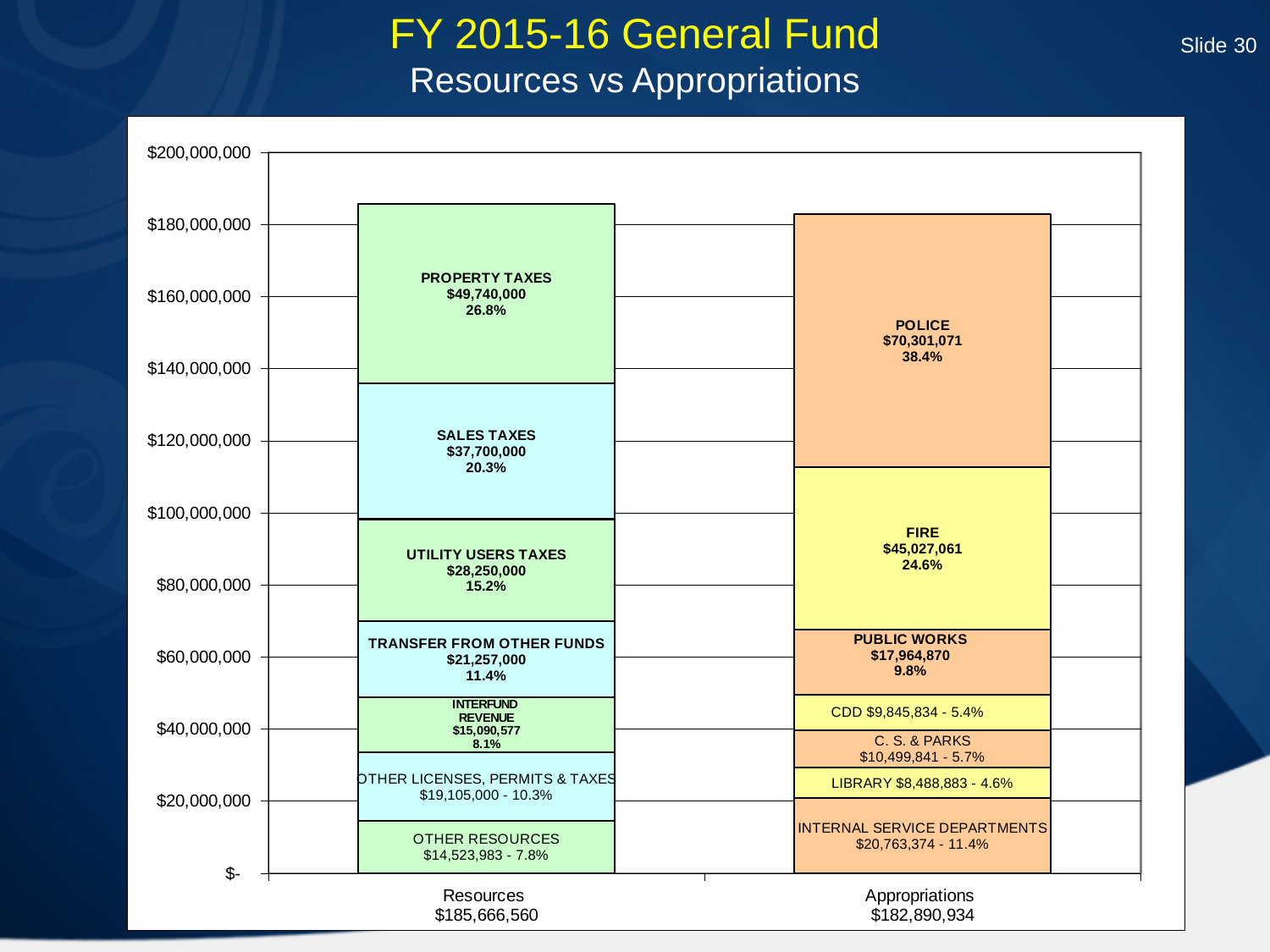
What is the value of the Fire segment in the Appropriations bar? $45,027,061 Which is larger, the Sales Taxes segment or the Utility Users Taxes segment? Sales Taxes What is the value of the Property Taxes segment in the Resources bar? $49,740,000 How many bars (categories) are plotted on the x axis? 2 What percentage of Appropriations does Police account for? 38.4% Which segment is the smallest in the Appropriations bar? Library What is the difference between the Police and Fire appropriations? $25,274,010 Which segment is the largest in the Appropriations bar? Police What is the total of the Appropriations bar? $182,890,934 What is the value of the Internal Service Departments segment? $20,763,374 What kind of chart is shown on the slide? Stacked bar chart What is the total of the Resources bar? $185,666,560